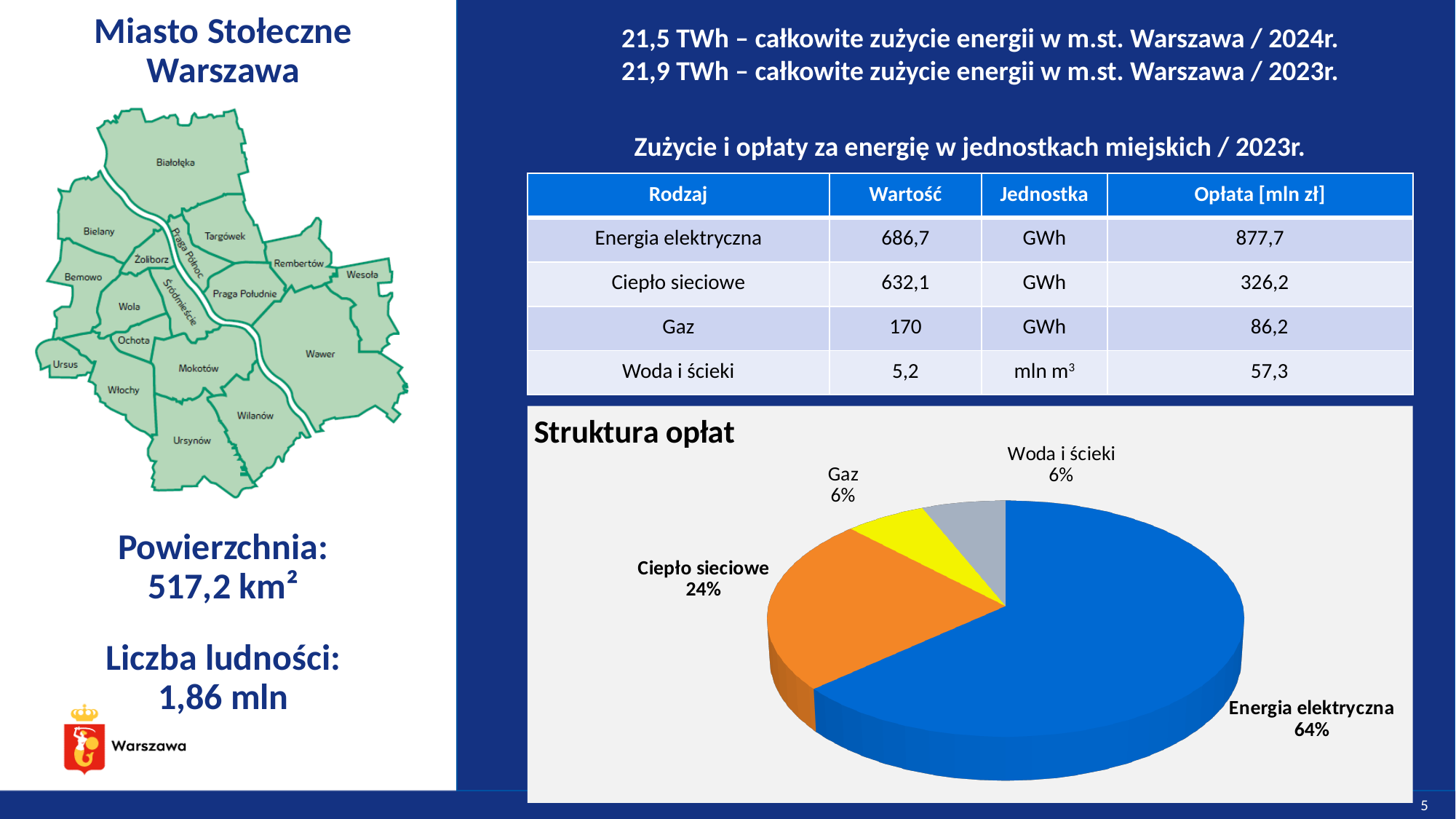
What kind of chart is shown under the title "Struktura opłat"? pie chart In the "Struktura opłat" pie chart, which is larger: the share for "Ciepło sieciowe" or the share for "Gaz"? Ciepło sieciowe In the "Struktura opłat" pie chart, is the share for "Energia elektryczna" greater or less than 50%? greater What colour is the "Ciepło sieciowe" slice in the "Struktura opłat" pie chart? orange How many slices does the "Struktura opłat" pie chart have? 4 What share of the pie does "Gaz" represent in the "Struktura opłat" chart? 6% What share of the pie does "Ciepło sieciowe" represent in the "Struktura opłat" chart? 24% What share of the pie does "Energia elektryczna" represent in the "Struktura opłat" chart? 64% What is the title of the pie chart on the slide? Struktura opłat In the "Struktura opłat" pie chart, how many percentage points larger is the "Energia elektryczna" share than the "Ciepło sieciowe" share? 40 Which category has the largest slice in the "Struktura opłat" pie chart? Energia elektryczna